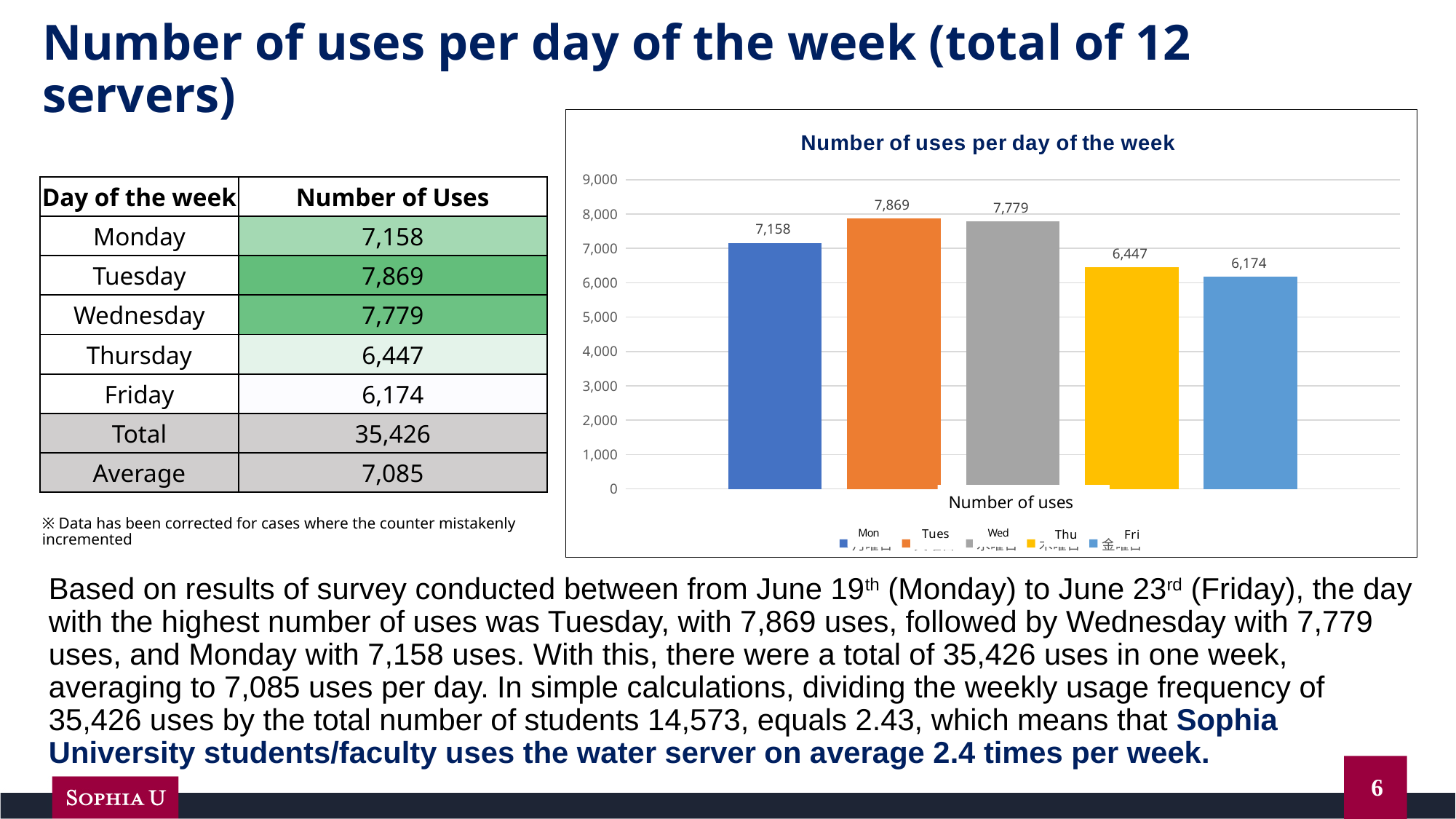
What is the number of uses for Monday in the chart? 7,158 What is the number of uses for Tuesday in the chart? 7,869 Which day has the lowest number of uses in the chart? Friday Which day has the highest number of uses in the chart? Tuesday What is the title of the chart? Number of uses per day of the week What is the number of uses for Friday in the chart? 6,174 Which has more uses, Monday or Thursday? Monday How many bars are shown in the chart? 5 What is the difference in number of uses between Thursday and Friday? 273 What kind of chart is shown on the slide? Bar chart What is the difference in number of uses between Tuesday and Wednesday? 90 Is the value for Wednesday greater or less than 7,000? greater